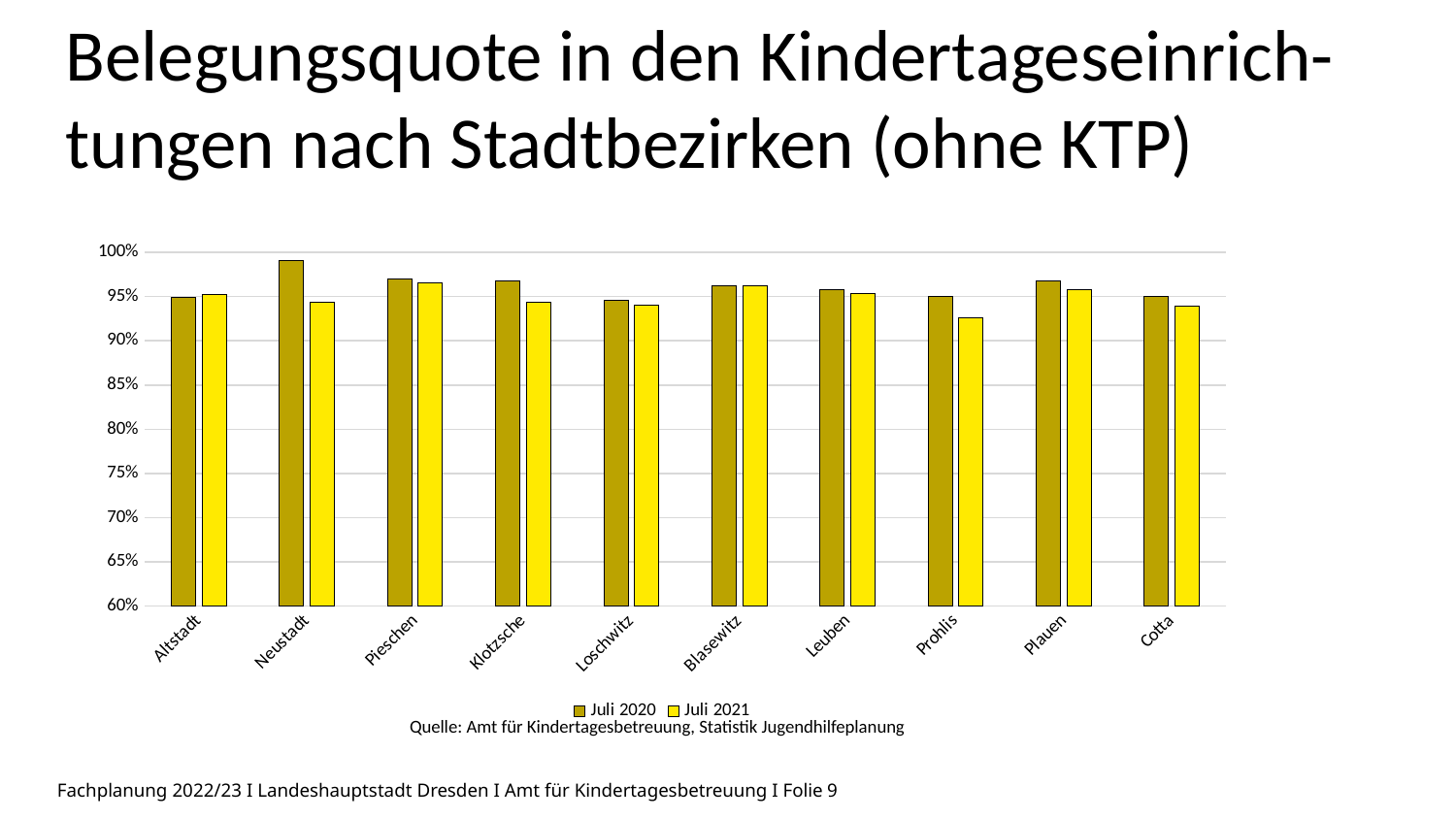
For Neustadt, which is larger: the Juli 2020 value or the Juli 2021 value? Juli 2020 Which Stadtbezirk has the highest value for Juli 2020? Neustadt Which Stadtbezirk has the lowest value for Juli 2021? Prohlis Is the Juli 2020 value for Pieschen greater or less than 95%? greater What are the two series named in the legend? Juli 2020 and Juli 2021 How many series does the legend list? 2 How many Stadtbezirke (categories) are shown on the x axis? 10 For Prohlis, which is larger: the Juli 2020 value or the Juli 2021 value? Juli 2020 Is the Juli 2020 value for Neustadt greater or less than 95%? greater What is the lowest value shown on the y axis? 60% What kind of chart is shown on the slide? bar chart Is the Juli 2021 value for Prohlis greater or less than 95%? less